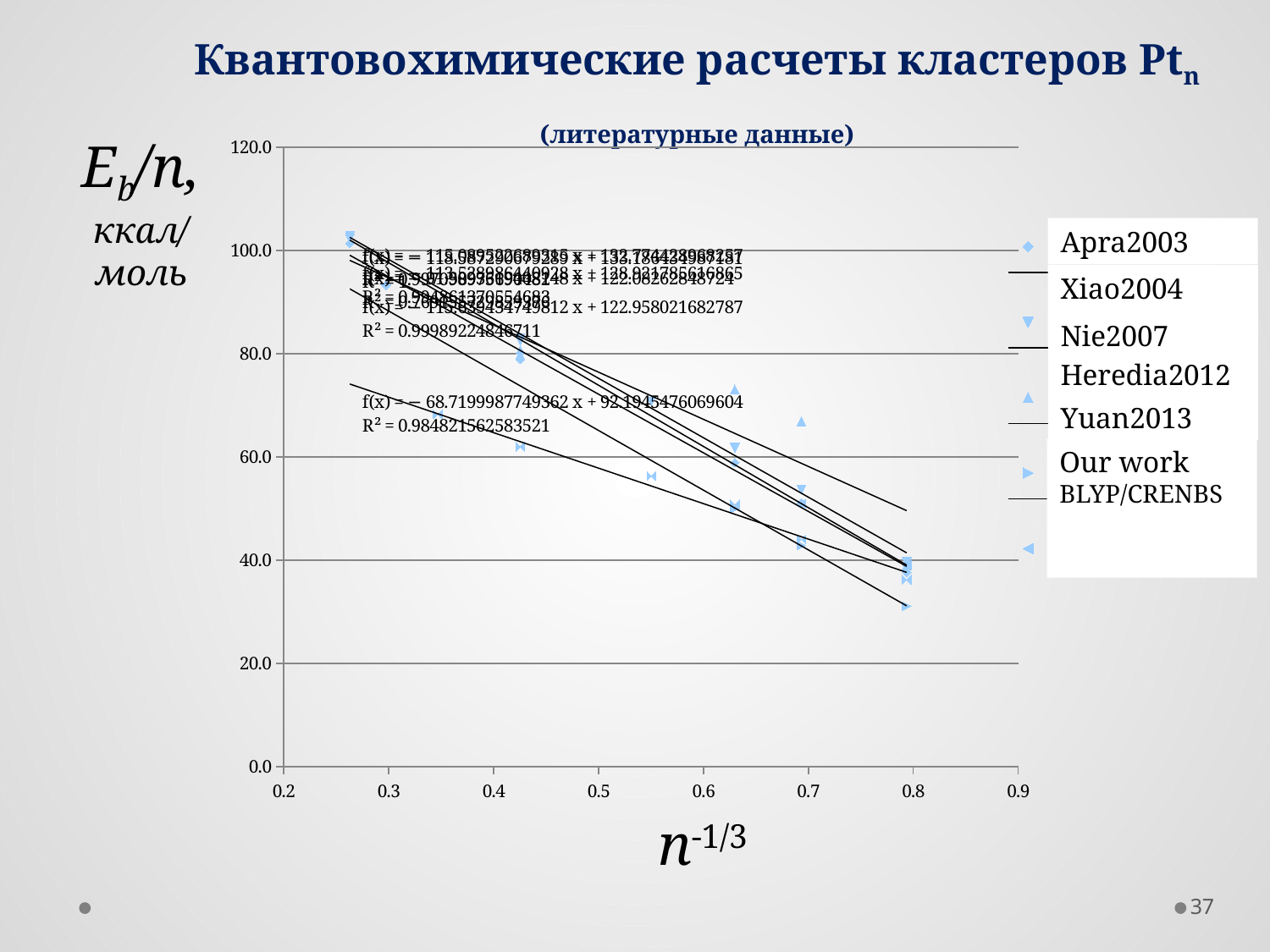
What is the lowest value shown on the x axis? 0.2 Do the plotted values rise or fall as n^-1/3 increases along the x axis? fall What kind of chart is shown on the slide? scatter chart Is the Apra2003 value at n^-1/3 ≈ 0.26 greater or less than 80? greater What is the title printed above the chart? (литературные данные) Which series is listed last in the legend? Our work BLYP/CRENBS Is the Apra2003 value at n^-1/3 ≈ 0.42 greater or less than 60? greater How many series does the legend list? 6 Are the plotted values at n^-1/3 ≈ 0.8 greater or less than 60? less